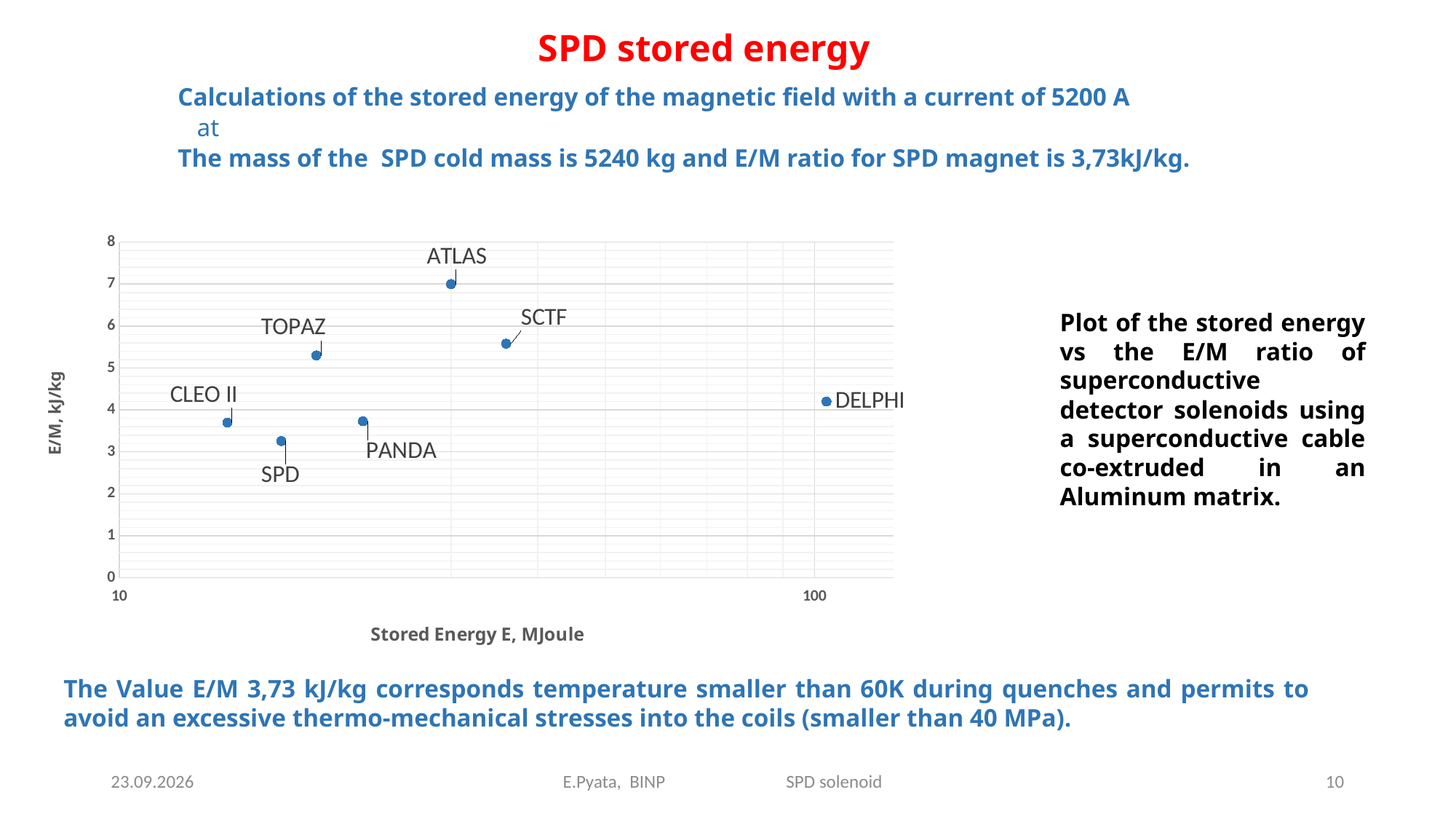
What is the label of the y axis of the chart? E/M, kJ/kg Which has a higher E/M ratio, TOPAZ or PANDA? TOPAZ Which detector solenoid has the highest E/M ratio on the chart? ATLAS Which detector solenoid has the lowest stored energy on the chart? CLEO II Which detector solenoid has the highest stored energy on the chart? DELPHI Is the E/M value for ATLAS greater or less than 6? greater Is the E/M value for SCTF greater or less than 5? greater Which detector solenoid has the lowest E/M ratio on the chart? SPD What is the label of the x axis of the chart? Stored Energy E, MJoule How many labeled data points are plotted on the chart? 7 What kind of chart is shown on the slide? scatter plot Is the E/M value for SPD greater or less than 4? less